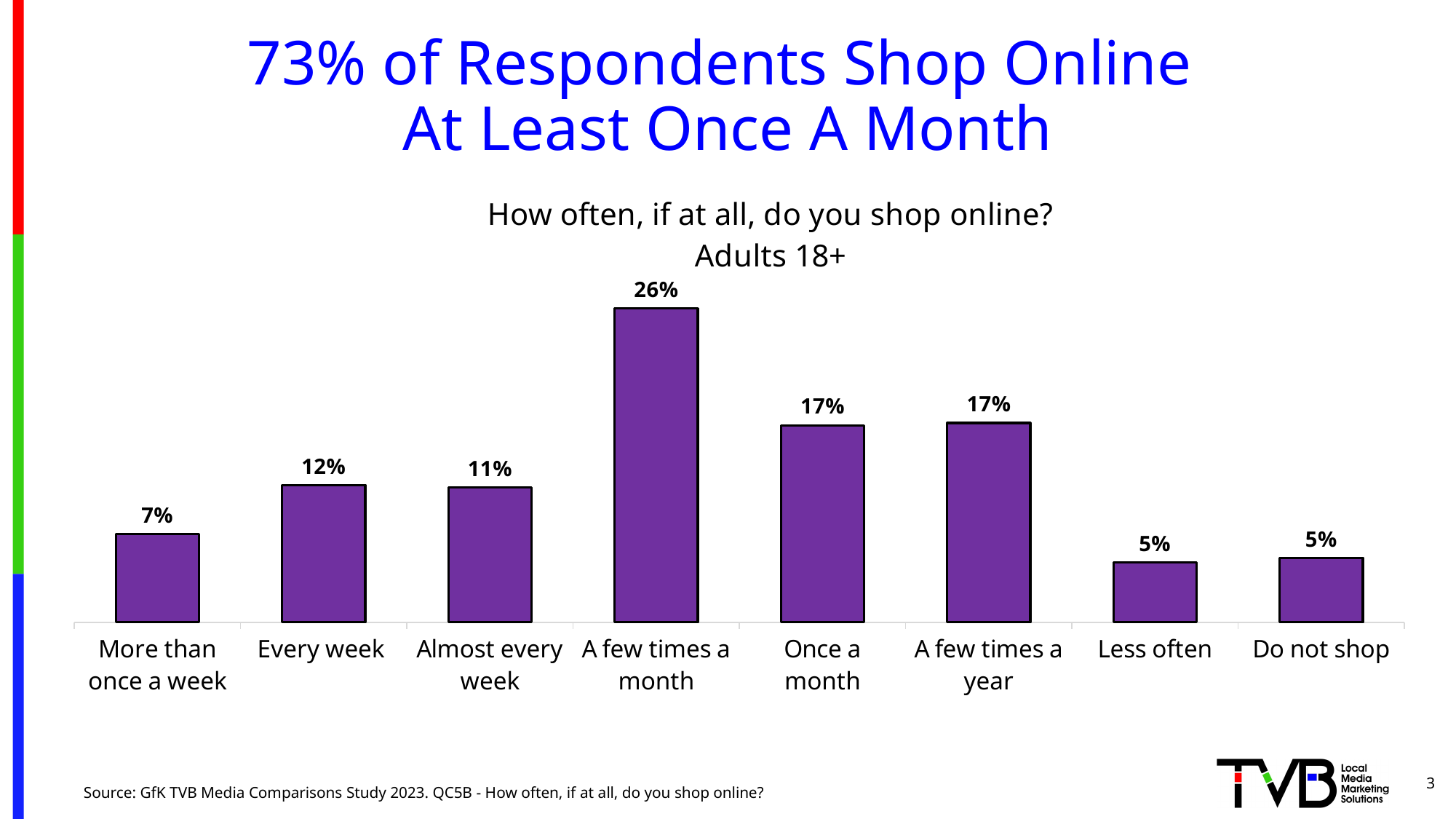
What is the value for 'More than once a week'? 7% Which category has the highest value? A few times a month What colour are the bars in the chart? Purple What is the difference between 'A few times a month' and 'Once a month'? 9% What is the difference between 'Every week' and 'Almost every week'? 1% What is the combined value of 'Less often' and 'Do not shop'? 10% What kind of chart is shown on the slide? Bar chart What percentage of respondents do not shop online? 5% What percentage of respondents shop online a few times a month? 26% How many categories are shown on the x axis? 8 What is the title of the chart? How often, if at all, do you shop online? Adults 18+ Which is larger, the value for 'Every week' or the value for 'More than once a week'? Every week